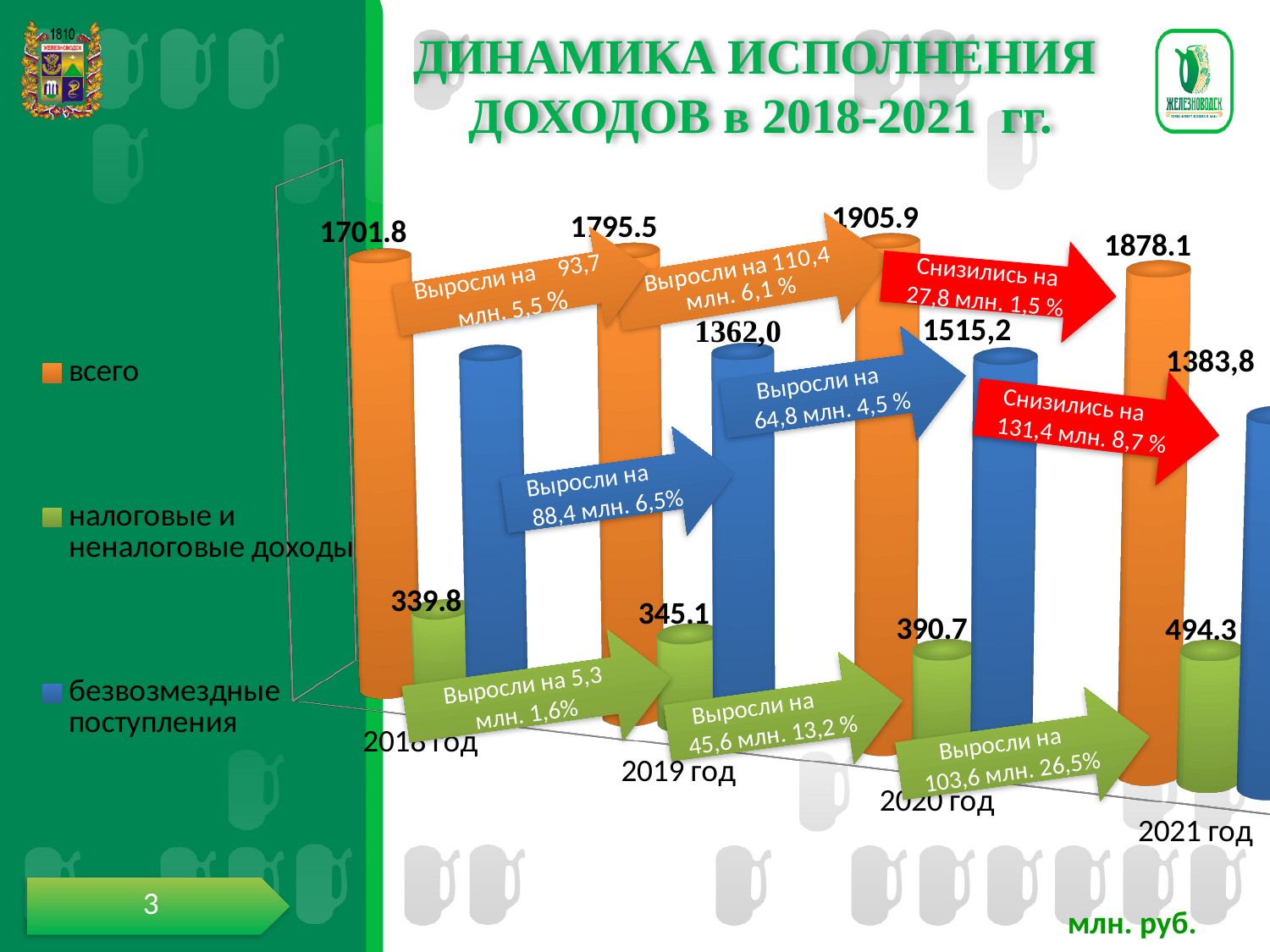
What is the value for налоговые и неналоговые доходы in 2021 год? 494.3 How many years are shown on the x axis? 4 How many series does the legend list? 3 What kind of chart is shown on the slide? bar chart Do the values for налоговые и неналоговые доходы rise or fall from 2018 год to 2021 год? rise What is the value for всего in 2018 год? 1701.8 What is the difference between the всего values for 2020 год and 2019 год? 110.4 In which year is the value for всего the highest? 2020 год In which year is the value for налоговые и неналоговые доходы the lowest? 2018 год Which is larger: безвозмездные поступления in 2020 год or in 2021 год? 2020 год What is the value for всего in 2020 год? 1905.9